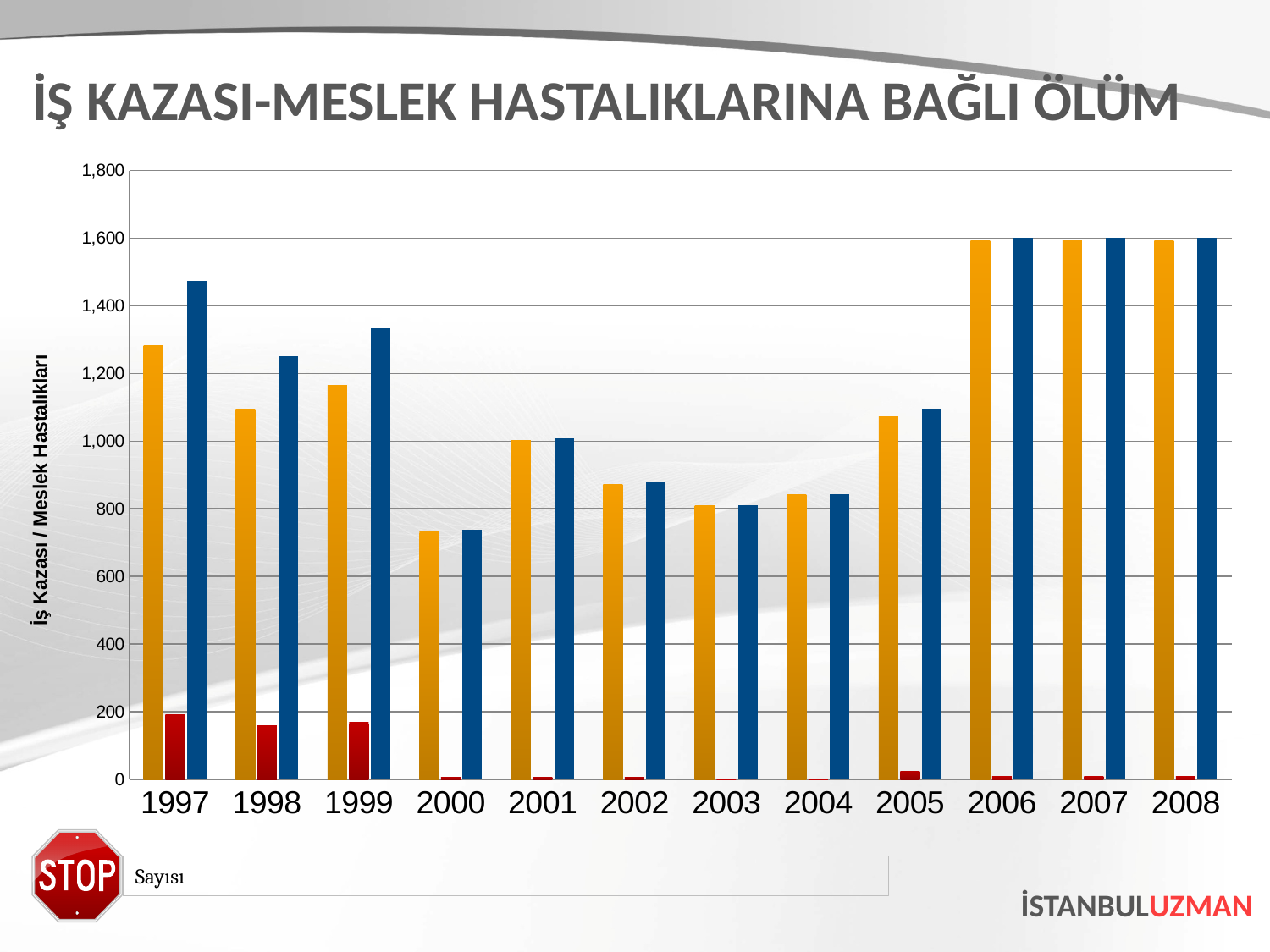
How many bars are shown for each year in the chart? 3 In which year is the blue bar the lowest? 2000 Which is larger, the orange bar for 1997 or the orange bar for 1998? 1997 Do the orange bars rise or fall from 1997 to 2000? fall Is the value of the red bar for 1997 greater or less than 400? less Is the value of the blue bar for 1997 greater or less than 1,400? greater What kind of chart is shown on the slide? Bar chart What is the title of the slide? İŞ KAZASI-MESLEK HASTALIKLARINA BAĞLI ÖLÜM In which year is the orange bar the lowest? 2000 How many years are shown on the x axis of the chart? 12 Is the value of the orange bar for 1997 greater or less than 1,200? greater